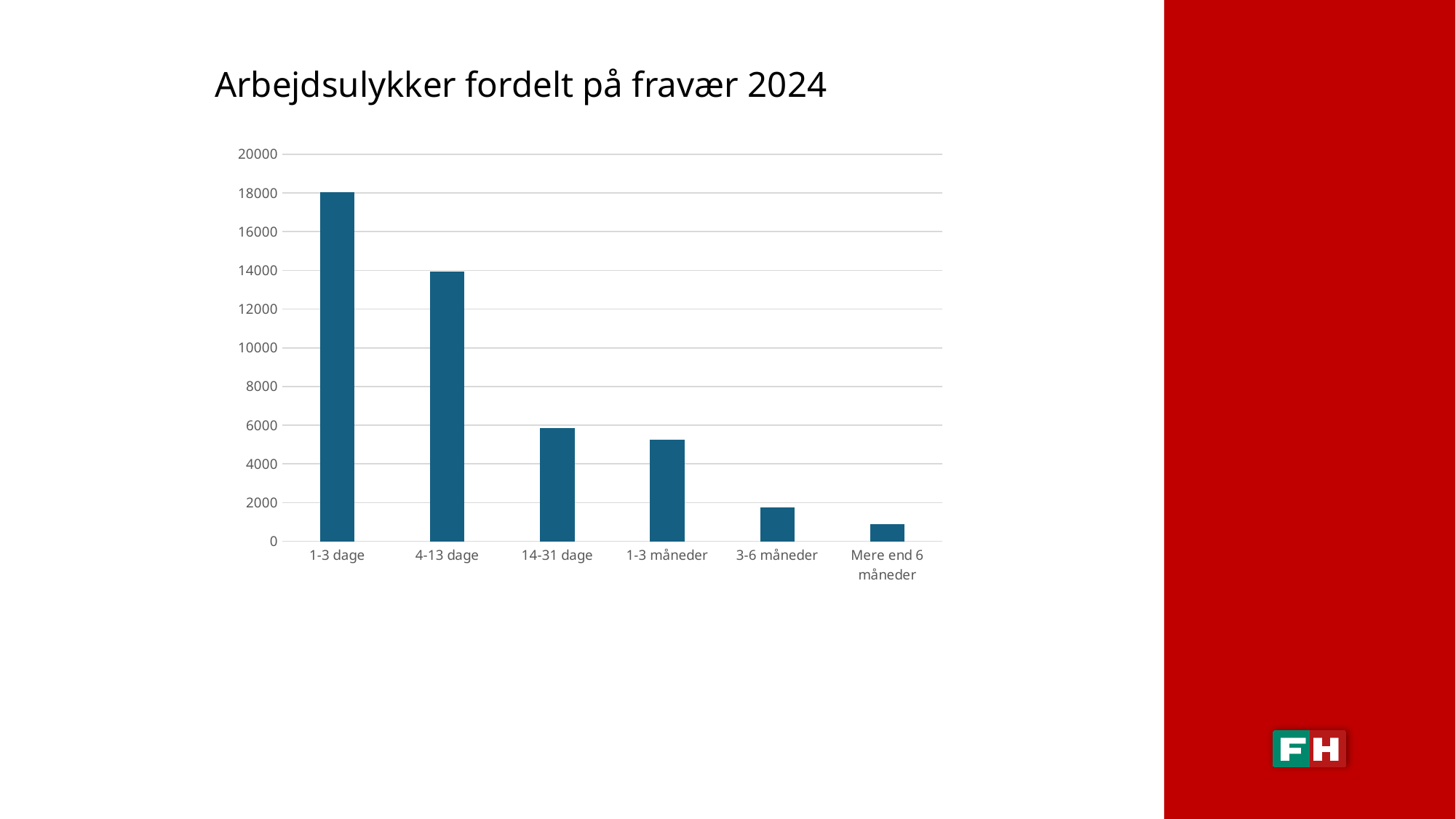
Which category has the lowest value? Mere end 6 måneder How many categories are shown on the x axis of the chart? 6 Is the value for 1-3 måneder greater or less than 4000? greater What is the title of the chart? Arbejdsulykker fordelt på fravær 2024 Do the values rise or fall from left to right along the x axis? fall Is the value for 1-3 dage greater or less than 16000? greater What kind of chart is shown on the slide? bar chart Which category has the highest value? 1-3 dage Which is larger, the value for 14-31 dage or the value for 1-3 måneder? 14-31 dage Is the value for 3-6 måneder greater or less than 2000? less